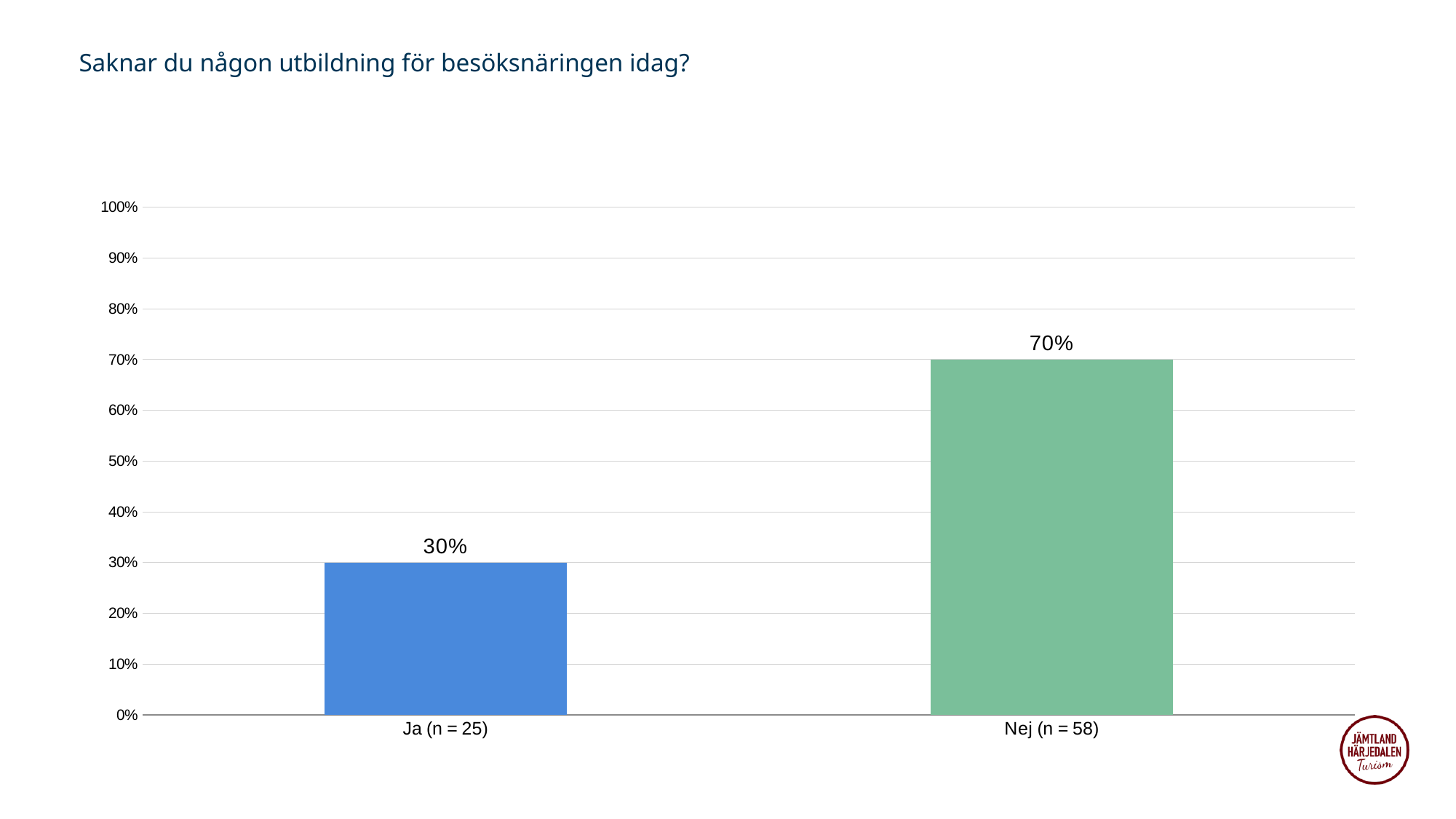
What is the value for "Ja (n = 25)"? 30% Is the value for "Nej (n = 58)" greater or less than 50%? greater What is the difference between the values for "Nej (n = 58)" and "Ja (n = 25)"? 40% How many categories are shown on the x axis? 2 What is the highest value shown on the y axis? 100% What is the value for "Nej (n = 58)"? 70% What is the title of the slide? Saknar du någon utbildning för besöksnäringen idag? What kind of chart is shown on the slide? Bar chart Which is larger, the value for "Ja (n = 25)" or the value for "Nej (n = 58)"? Nej (n = 58) Which category has the lowest value? Ja (n = 25) Is the value for "Ja (n = 25)" greater or less than 40%? less Which category has the highest value? Nej (n = 58)